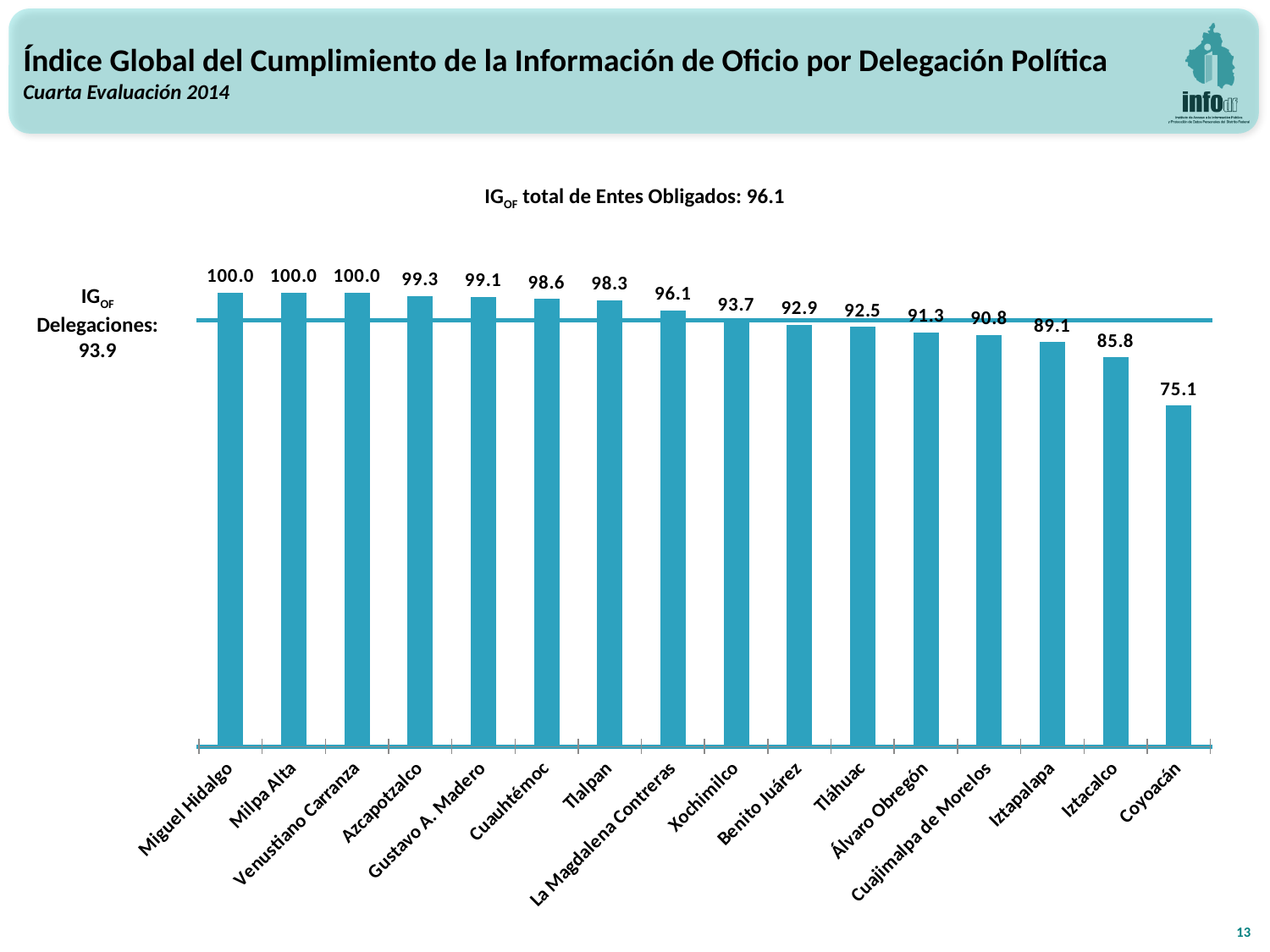
What value does the horizontal line labelled IGOF Delegaciones mark? 93.9 Do the values rise or fall from left to right along the x axis? fall What is the difference between the values for Iztacalco and Coyoacán? 10.7 What kind of chart is shown on the slide? bar chart What is the value for Cuajimalpa de Morelos? 90.8 How many delegaciones are shown on the chart? 16 Which is larger, the value for Benito Juárez or the value for Iztapalapa? Benito Juárez Which delegación has the lowest value? Coyoacán What is the value for Tlalpan? 98.3 How many delegaciones have a value of 100.0? 3 What is the value for Coyoacán? 75.1 What is the difference between the values for Azcapotzalco and Xochimilco? 5.6